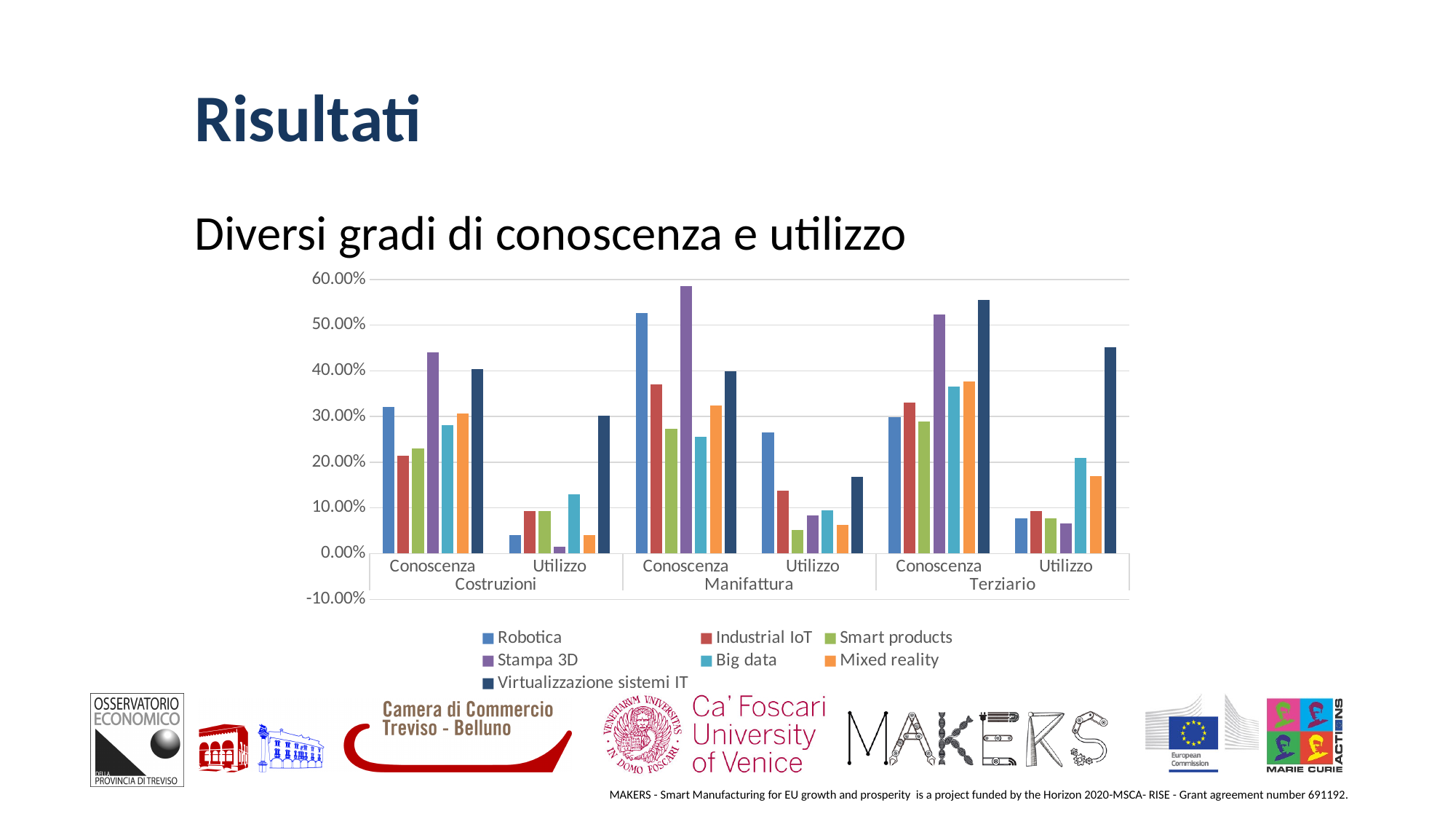
Which series has the lowest bar under Costruzioni Utilizzo? Stampa 3D Under Costruzioni Utilizzo, which is larger: Stampa 3D or Big data? Big data How many sectors are shown along the x axis? 3 Which series has the tallest bar in the whole chart? Stampa 3D (Manifattura, Conoscenza) Is the value for Virtualizzazione sistemi IT under Terziario Utilizzo greater or less than 40.00%? greater For Manifattura, are the Utilizzo bars generally higher or lower than the Conoscenza bars? lower What kind of chart is shown on the slide? bar chart Is the value for Stampa 3D under Costruzioni Conoscenza greater or less than 40.00%? greater Which series has the highest bar under Terziario Utilizzo? Virtualizzazione sistemi IT How many series does the legend list? 7 What colour represents Stampa 3D in the legend? purple Is the value for Robotica under Manifattura Conoscenza greater or less than 50.00%? greater